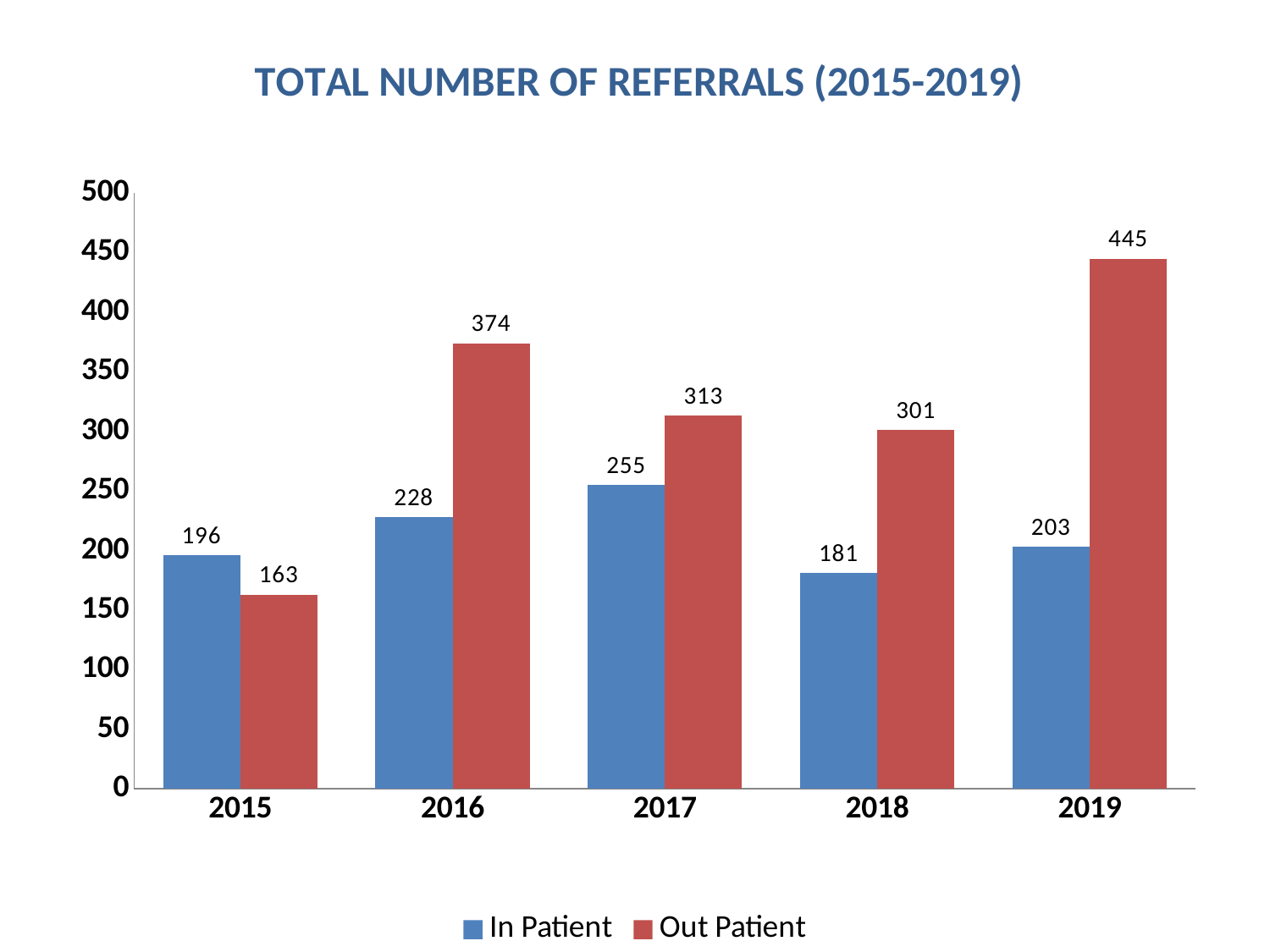
What is the In Patient value for 2017? 255 Which is larger in 2015, In Patient or Out Patient? In Patient How many years are shown on the x axis? 5 What is the Out Patient value for 2015? 163 What kind of chart is shown on the slide? Bar chart How many series does the legend list? 2 What is the Out Patient value for 2019? 445 What is the title of the chart? TOTAL NUMBER OF REFERRALS (2015-2019) Is the Out Patient value for 2018 greater or less than 250? greater Which year has the lowest In Patient value? 2018 Which year has the highest Out Patient value? 2019 What is the difference between the Out Patient and In Patient values in 2016? 146